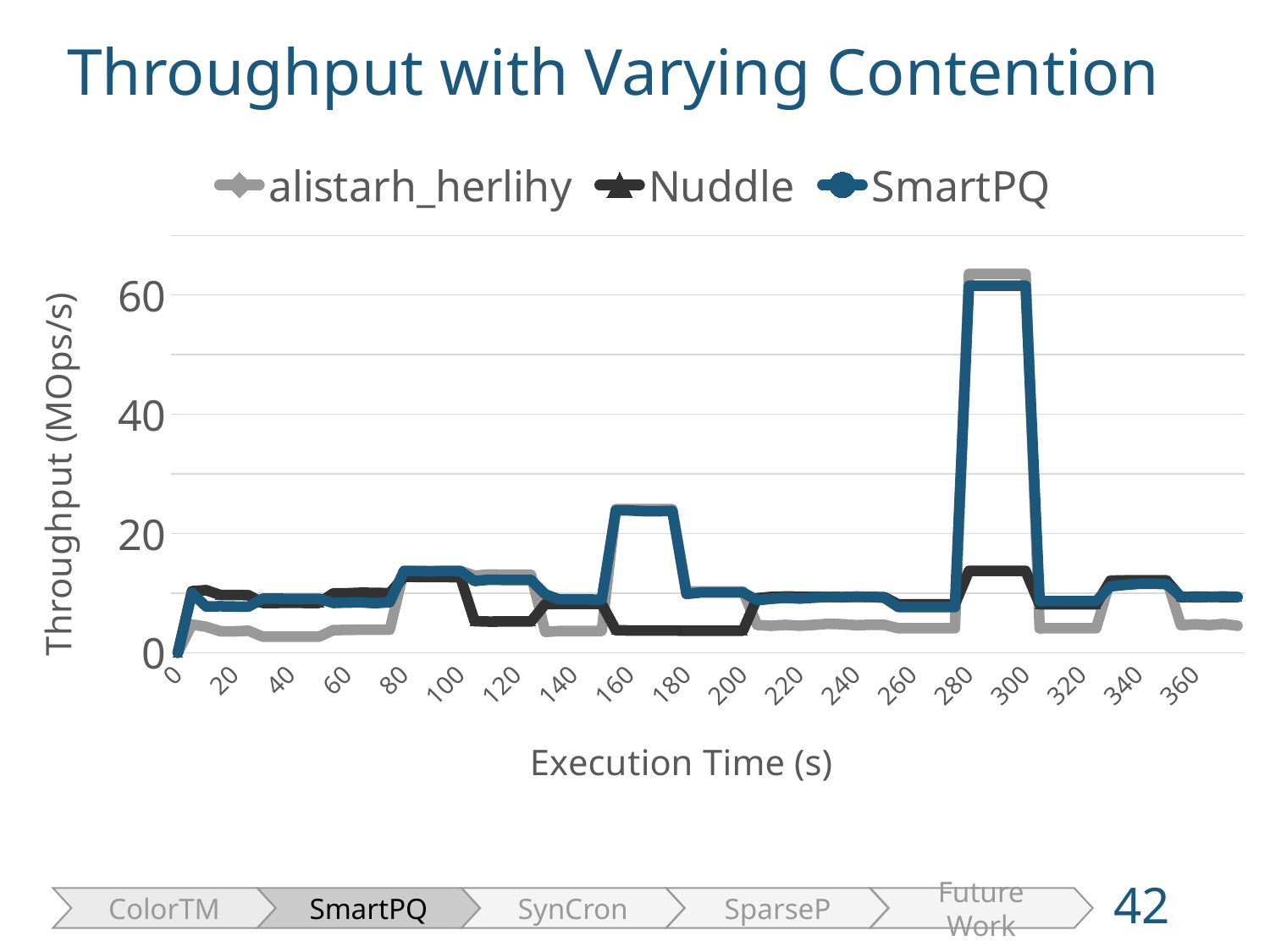
At execution time 170 s, which is larger: Nuddle or alistarh_herlihy? alistarh_herlihy Is the value for Nuddle at execution time 290 s greater or less than 20? less At execution time 290 s, which is larger: SmartPQ or Nuddle? SmartPQ What is the label of the y axis? Throughput (MOps/s) Is the value for Nuddle at execution time 170 s greater or less than 20? less Which series has the lowest peak value over the whole execution time? Nuddle Is the value for SmartPQ at execution time 290 s greater or less than 40? greater At execution time 40 s, which is larger: Nuddle or alistarh_herlihy? Nuddle What is the title of the chart? Throughput with Varying Contention What kind of chart is shown on the slide? line chart How many series does the legend list? 3